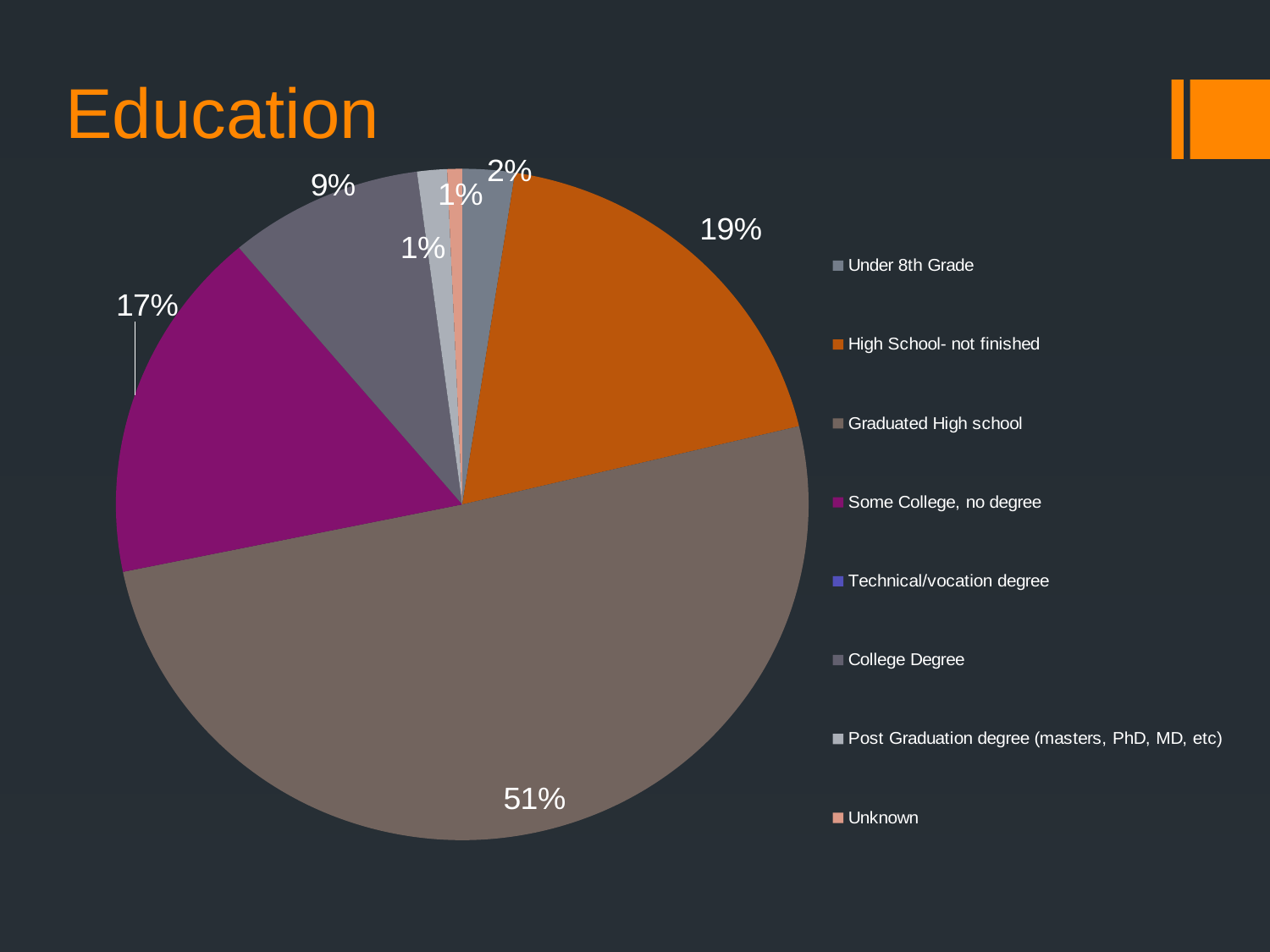
How many categories does the legend list? 8 Which is larger, the share for Technical/vocation degree or the share for Some College, no degree? Some College, no degree Which is larger, the share for High School- not finished or the share for Some College, no degree? High School- not finished What share of the pie does Under 8th Grade represent? 2% What share of the pie does Some College, no degree represent? 17% What is the difference in percentage points between Graduated High school and High School- not finished? 32 percentage points What share of the pie does High School- not finished represent? 19% What is the title of the chart? Education What type of chart is shown on the slide? Pie chart Which category has the largest share of the pie? Graduated High school